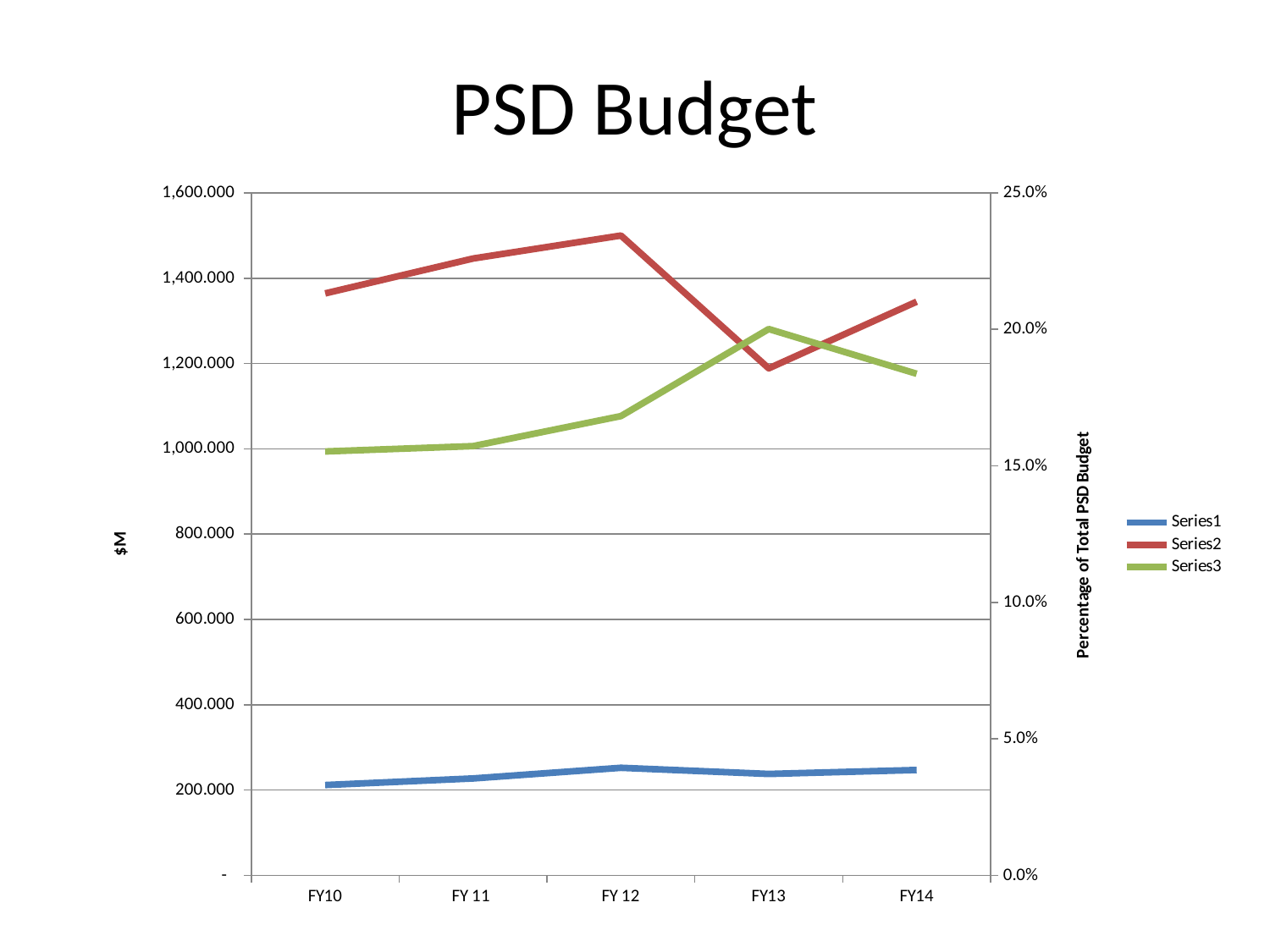
What kind of chart is shown on the slide? line chart In which fiscal year is Series1 at its lowest? FY10 How many series does the legend list? 3 In which fiscal year does Series2 reach its highest point? FY 12 Does Series2 rise or fall from FY 12 to FY13? fall How many fiscal years are plotted along the x axis? 5 In which fiscal year does Series2 reach its lowest point? FY13 What is the label of the right-hand vertical axis? Percentage of Total PSD Budget What is the title of the chart? PSD Budget Does Series3 rise or fall from FY10 to FY13? rise Read against the left ($M) axis, is the value for Series1 in FY10 greater or less than 400.000? less In which fiscal year does Series3 reach its highest point? FY13